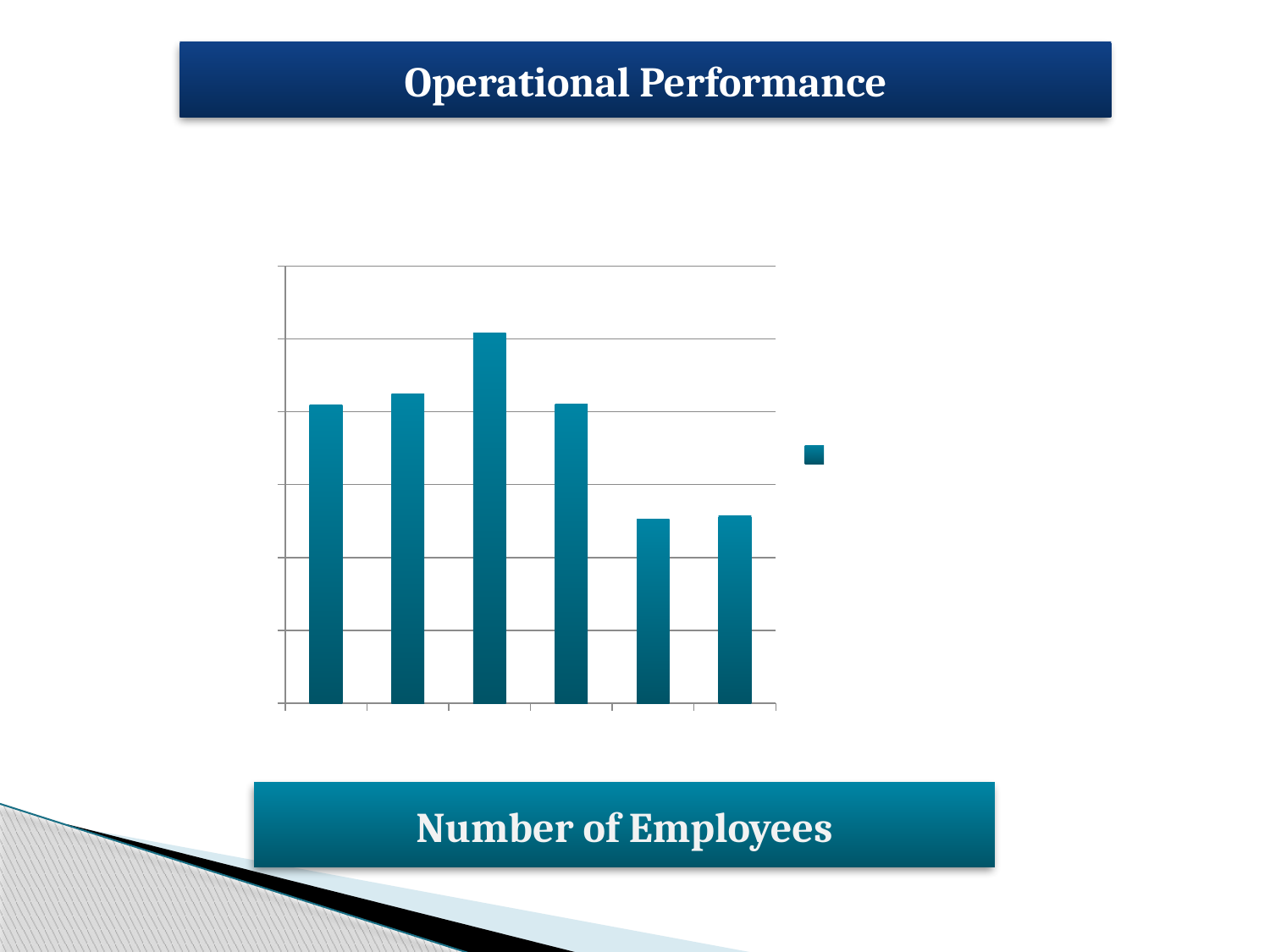
How many series does the chart's legend show? 1 Is the third bar from the left taller or shorter than the fourth bar? taller What label appears in the banner below the chart? Number of Employees Do the bars rise steadily from left to right across the chart? no How many bars are plotted in the chart? 6 Is the sixth bar from the left taller or shorter than the fourth bar? shorter Is the second bar from the left taller or shorter than the fifth bar? taller What is the title in the banner at the top of the slide? Operational Performance Which bar, counting from the left, is the tallest in the chart? the third bar What kind of chart is shown on the slide? bar chart Do the bars fall from the third bar to the fifth bar? yes